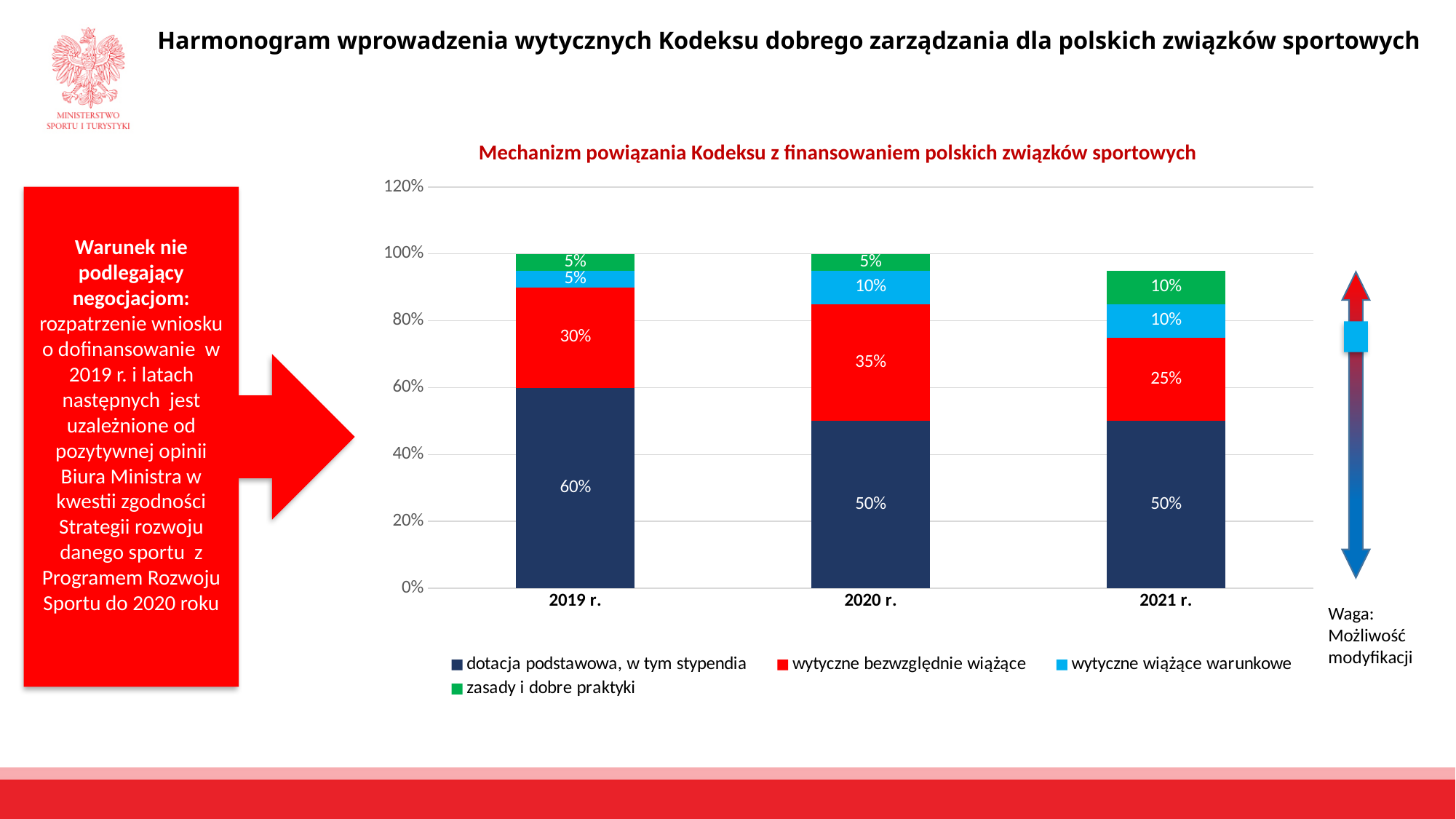
What kind of chart is shown on the slide? Stacked bar chart How many series does the legend list? 4 How many years are shown on the x axis? 3 What is the value for 'dotacja podstawowa, w tym stypendia' in 2019 r.? 60% In which year is the value for 'wytyczne bezwzględnie wiążące' the highest? 2020 r. Which is larger: 'wytyczne wiążące warunkowe' in 2019 r. or in 2021 r.? 2021 r. What is the value for 'wytyczne bezwzględnie wiążące' in 2020 r.? 35% In which year is the value for 'wytyczne bezwzględnie wiążące' the lowest? 2021 r. What is the total of the stacked bar for 2021 r.? 95% What is the value for 'zasady i dobre praktyki' in 2021 r.? 10% What is the value for 'wytyczne wiążące warunkowe' in 2019 r.? 5% What is the difference between the 'dotacja podstawowa, w tym stypendia' values for 2019 r. and 2020 r.? 10%